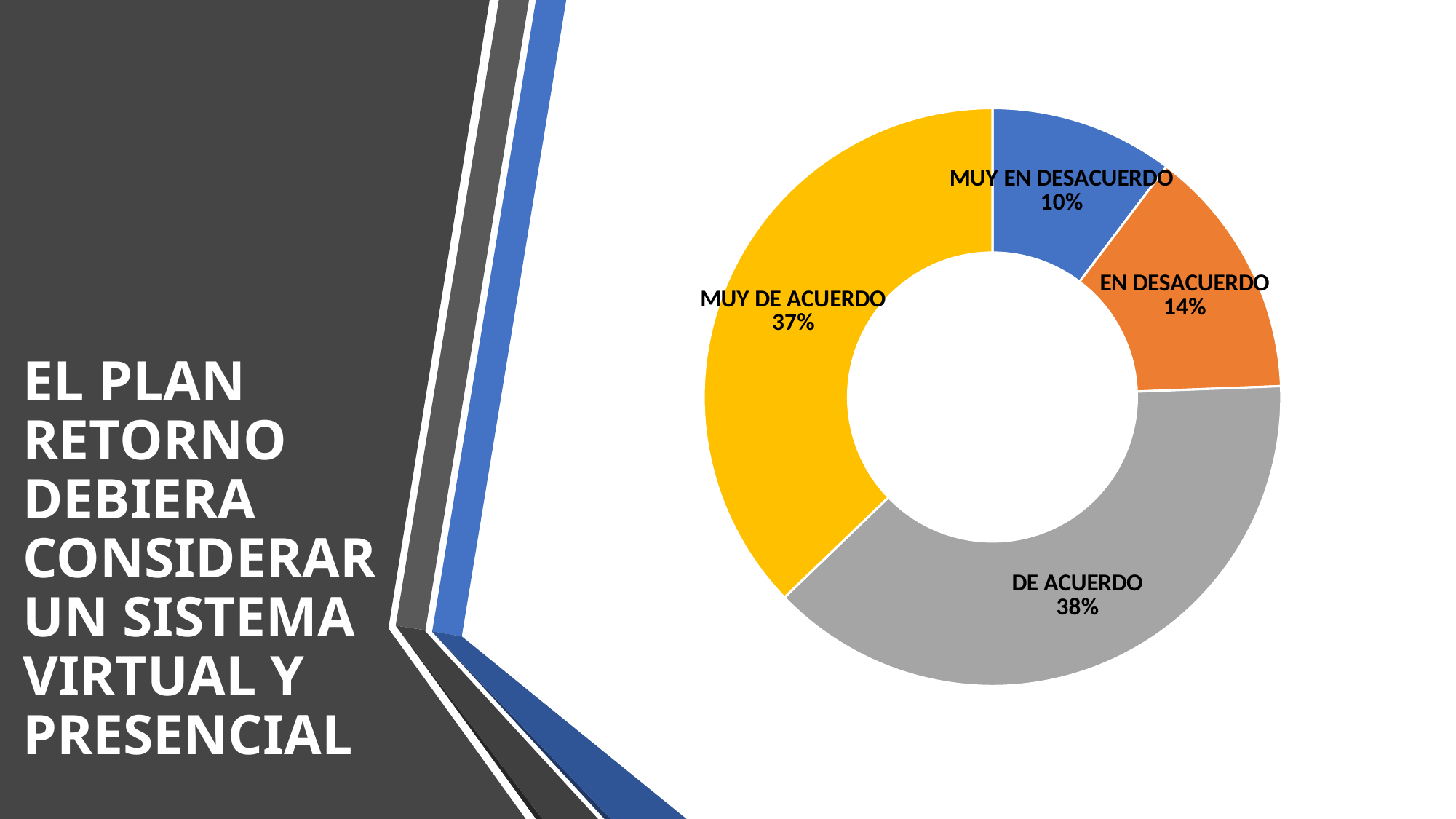
What is the combined percentage of DE ACUERDO and MUY DE ACUERDO? 75% Which category has the largest share of the chart? DE ACUERDO What percentage of respondents answered MUY DE ACUERDO? 37% What percentage of respondents answered DE ACUERDO? 38% What percentage of respondents answered MUY EN DESACUERDO? 10% How many categories are shown in the chart? 4 Which is larger, the share for MUY DE ACUERDO or the share for EN DESACUERDO? MUY DE ACUERDO Which category has the smallest share of the chart? MUY EN DESACUERDO What colour is the DE ACUERDO segment? Grey What is the difference in percentage points between EN DESACUERDO and MUY EN DESACUERDO? 4 What kind of chart is shown on the slide? Doughnut chart What percentage of respondents answered EN DESACUERDO? 14%